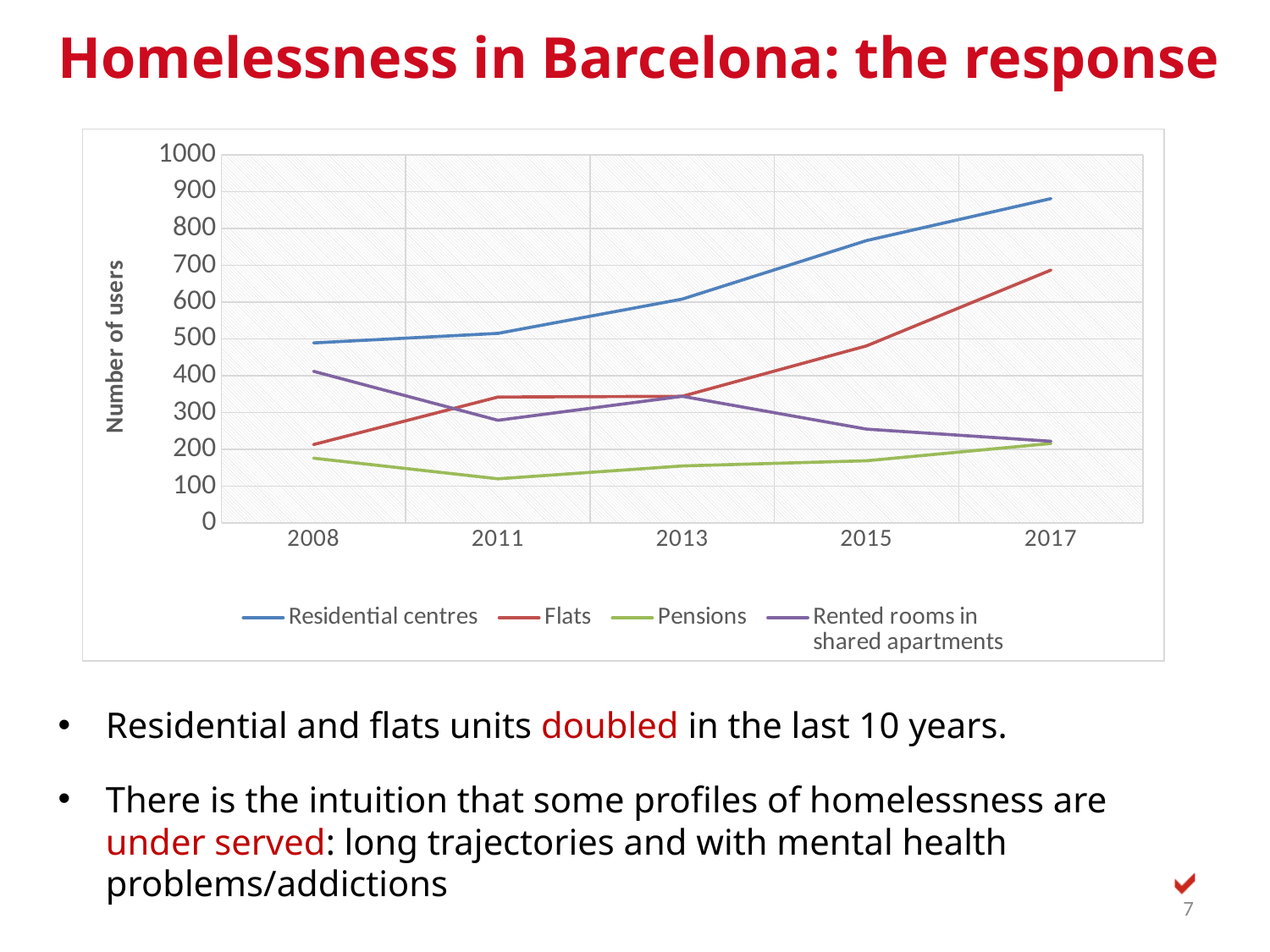
Do the values for Residential centres rise or fall from 2008 to 2017? rise Is the value for Flats in 2017 greater or less than 600? greater How many series does the legend list? 4 Is the value for Flats in 2008 greater or less than 300? less What is the title of the y axis? Number of users In 2008, which is larger: Rented rooms in shared apartments or Flats? Rented rooms in shared apartments How many years are shown on the x axis? 5 Is the value for Residential centres in 2017 greater or less than 800? greater What kind of chart is shown on the slide? line chart Which series has the highest number of users in 2017? Residential centres Do the values for Rented rooms in shared apartments rise or fall overall from 2008 to 2017? fall Which series has the lowest number of users in 2008? Pensions